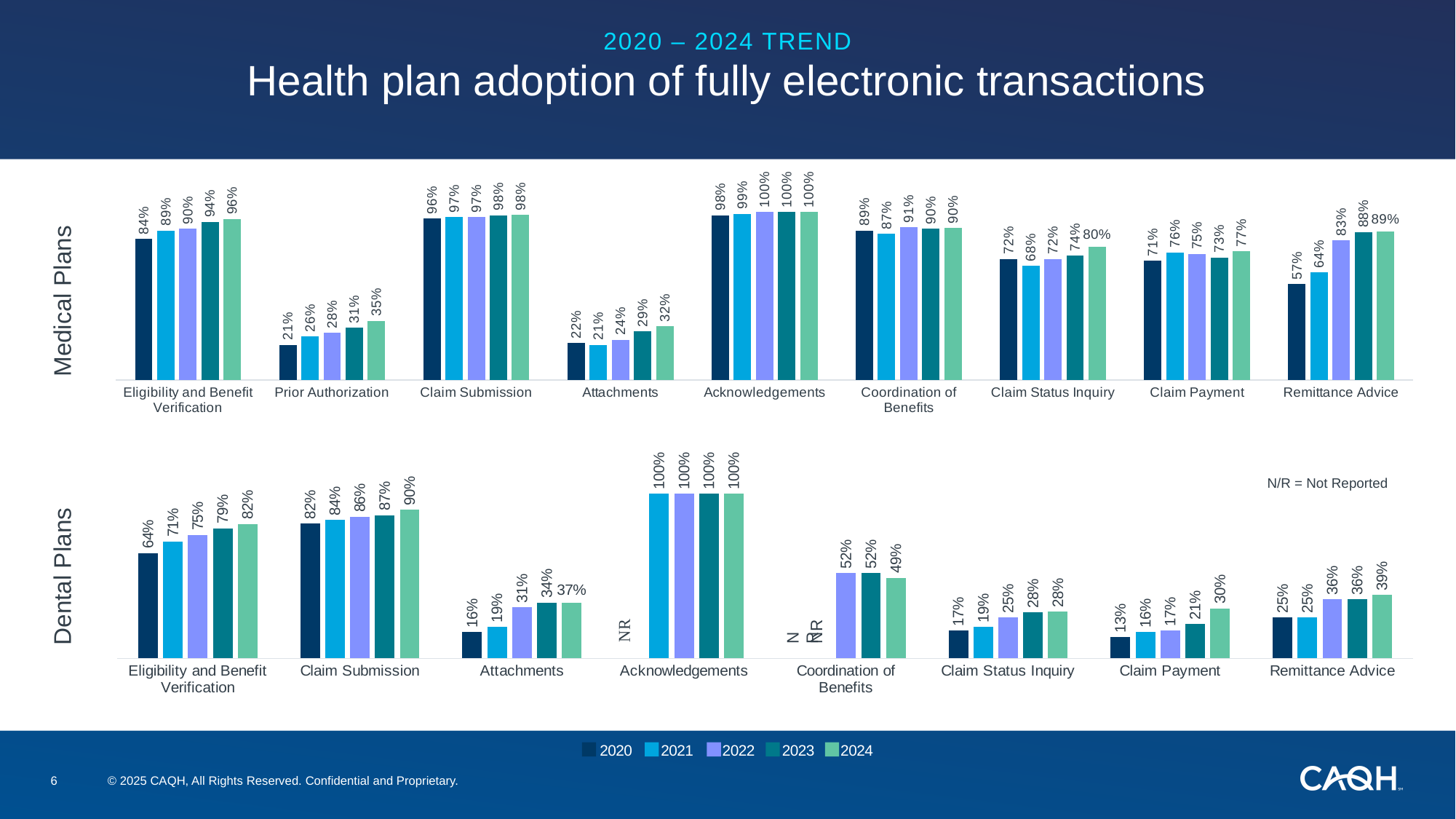
In the Medical Plans chart, what is the 2024 value for Prior Authorization? 35% In the Medical Plans chart, which is larger: the 2024 value for Claim Status Inquiry or the 2024 value for Claim Payment? Claim Status Inquiry In the Medical Plans chart, what is the difference between the 2024 and 2020 values for Remittance Advice? 32% In the Dental Plans chart, what is the 2022 value for Coordination of Benefits? 52% In the Dental Plans chart, do the values for Eligibility and Benefit Verification rise or fall from 2020 to 2024? rise How many series does the legend list? 5 In the Dental Plans chart, what is the difference between the 2024 and 2020 values for Attachments? 21% In the Medical Plans chart, what is the 2020 value for Remittance Advice? 57% In the Medical Plans chart, which category has the lowest 2020 value? Prior Authorization In the Dental Plans chart, what is the 2024 value for Claim Payment? 30% In the Dental Plans chart, which category has the highest 2024 value? Acknowledgements How many categories are shown in the Medical Plans chart? 9